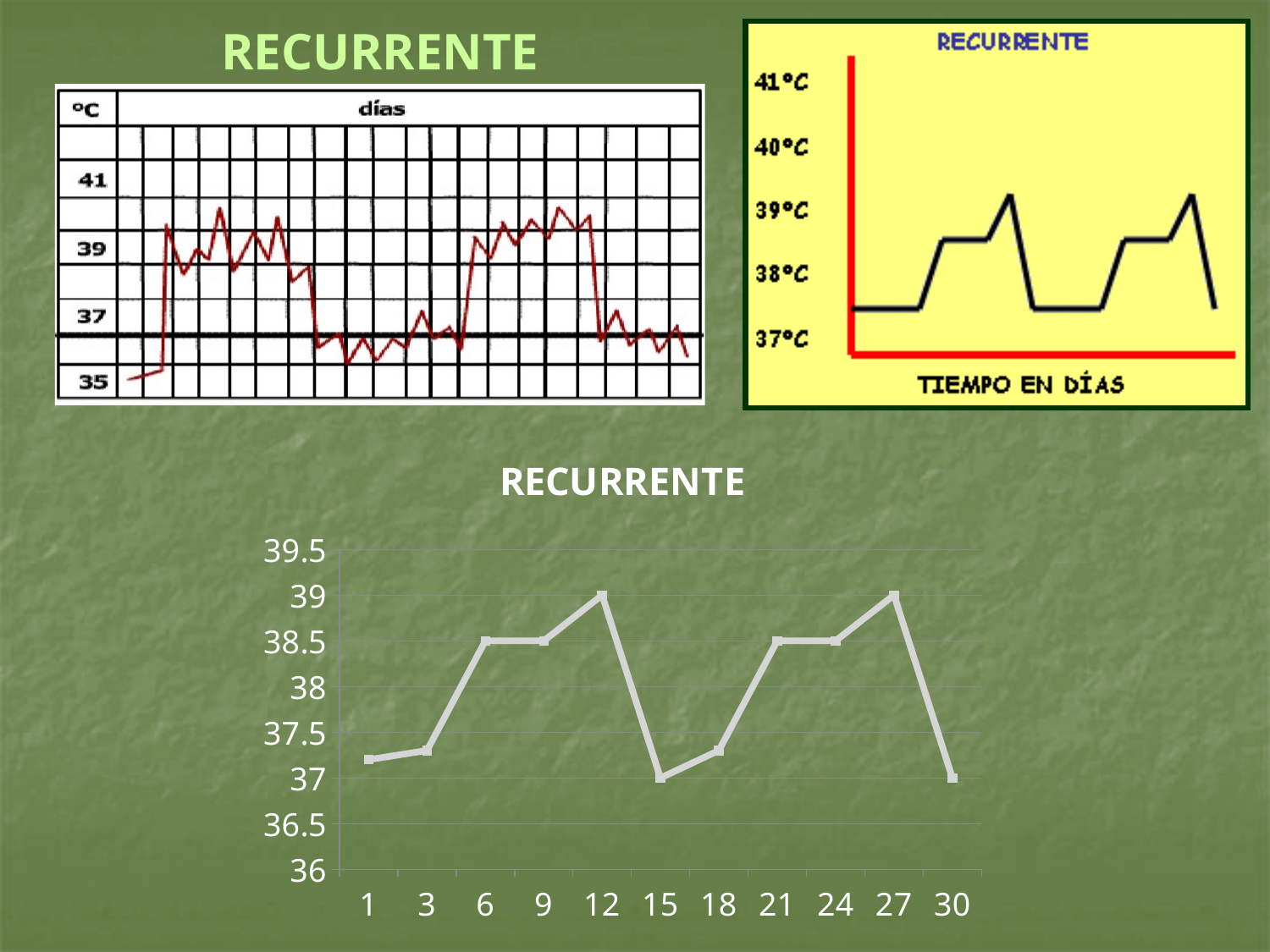
In the bottom chart titled RECURRENTE, which is larger, the value at day 12 or the value at day 9? day 12 In the bottom chart titled RECURRENTE, what is the value at day 6? 38.5 What is the title of the bottom chart on the slide? RECURRENTE In the bottom chart titled RECURRENTE, does the value rise or fall from day 12 to day 15? fall What kind of chart is the bottom chart titled RECURRENTE? line chart In the bottom chart titled RECURRENTE, what is the value at day 12? 39 In the bottom chart titled RECURRENTE, what is the value at day 15? 37 In the bottom chart titled RECURRENTE, is the value at day 18 greater or less than 37? greater How many day labels are shown on the x axis of the bottom chart titled RECURRENTE? 11 In the bottom chart titled RECURRENTE, what is the value at day 30? 37 In the bottom chart titled RECURRENTE, what is the difference between the values at day 27 and day 30? 2 In the bottom chart titled RECURRENTE, is the value at day 1 greater or less than 38? less